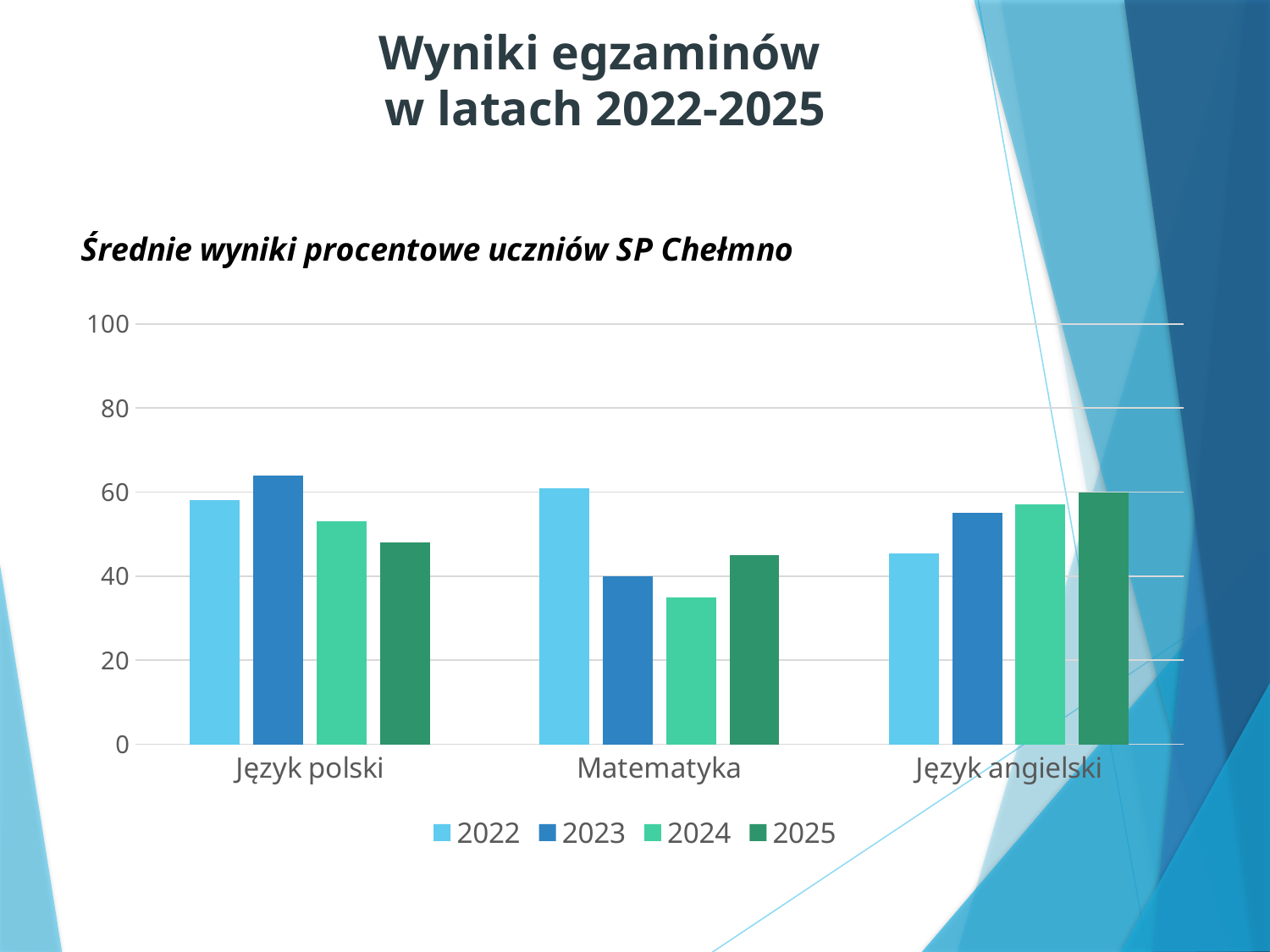
For Matematyka, which year has the highest bar? 2022 Which is larger: the 2022 value for Język polski or the 2024 value for Matematyka? Język polski 2022 Is the value for Język angielski in 2022 greater or less than 40? greater For Matematyka, which year has the lowest bar? 2024 What kind of chart is shown on the slide? bar chart How many series does the legend list? 4 How many subject categories are shown on the x axis? 3 For Język polski, which year has the highest bar? 2023 For Język angielski, do the values rise or fall from 2022 to 2025? rise Is the value for Język polski in 2023 greater or less than 60? greater For Język angielski, which year has the lowest bar? 2022 Is the value for Matematyka in 2024 greater or less than 40? less